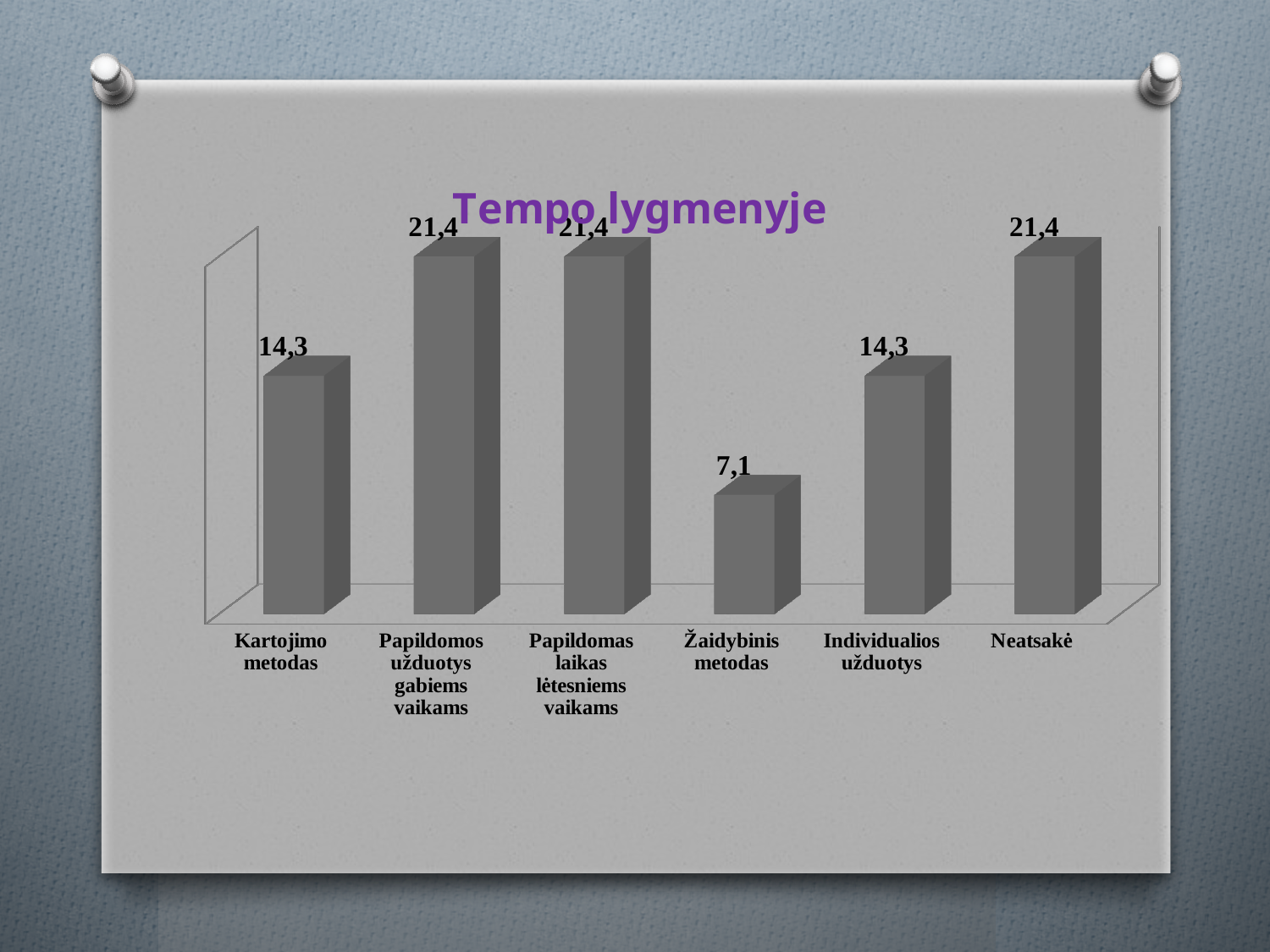
Which category has the lowest value? Žaidybinis metodas What is the value for Neatsakė? 21,4 What is the value for Kartojimo metodas? 14,3 Which is larger, the value for Individualios užduotys or the value for Žaidybinis metodas? Individualios užduotys What is the value for Papildomos užduotys gabiems vaikams? 21,4 What is the difference between the values for Neatsakė and Žaidybinis metodas? 14,3 What is the title of the chart? Tempo lygmenyje What is the difference between the values for Papildomas laikas lėtesniems vaikams and Kartojimo metodas? 7,1 What is the value for Žaidybinis metodas? 7,1 What is the value for Individualios užduotys? 14,3 How many categories are shown in the chart? 6 What kind of chart is shown on the slide? Bar chart